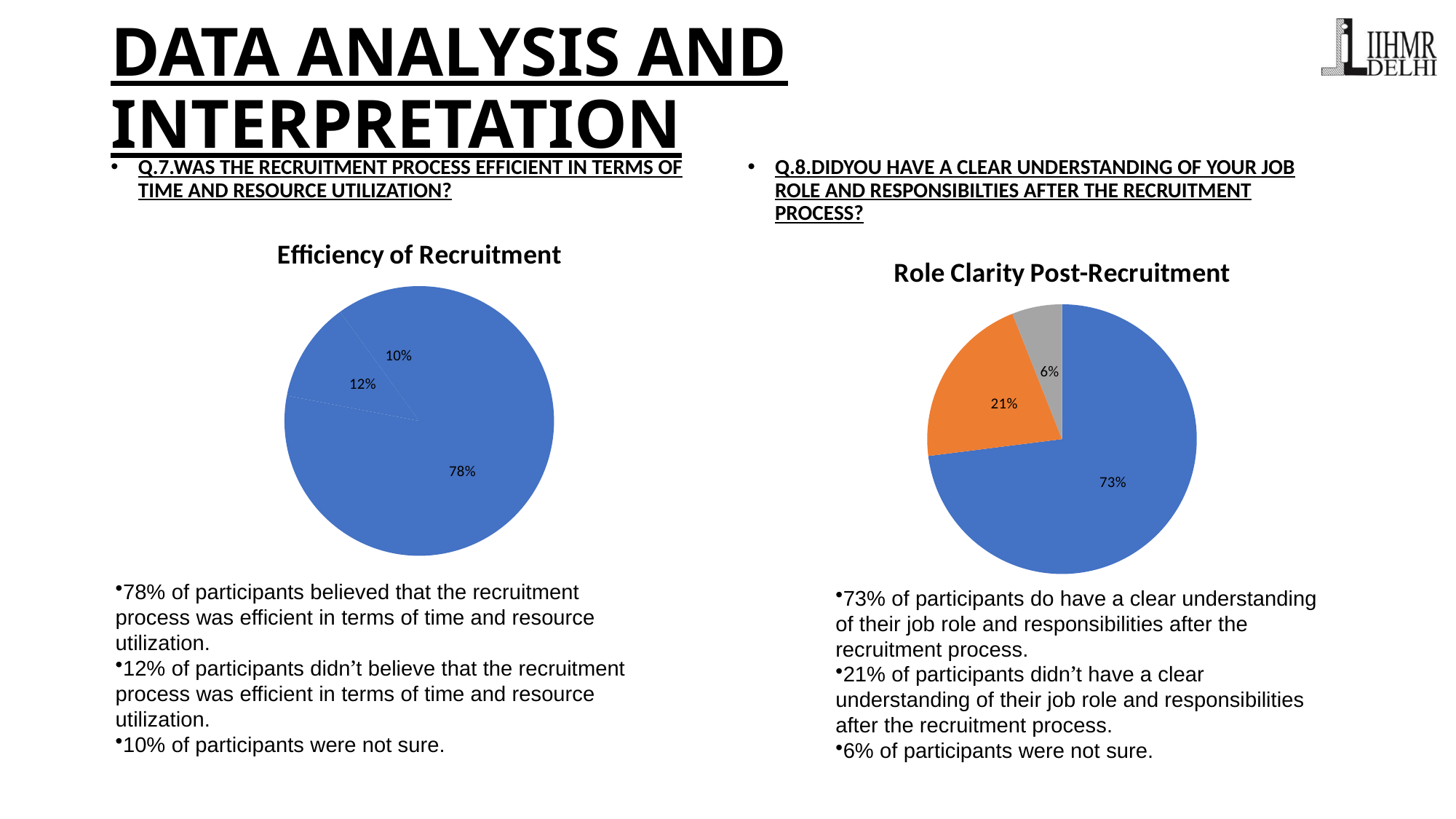
What kind of chart is the 'Efficiency of Recruitment' chart? pie chart In the 'Role Clarity Post-Recruitment' chart, what is the difference between the largest and smallest slices? 67% How many slices does the 'Efficiency of Recruitment' pie chart have? 3 Which chart has the larger largest slice, 'Efficiency of Recruitment' or 'Role Clarity Post-Recruitment'? Efficiency of Recruitment In the 'Efficiency of Recruitment' chart, what is the difference between the 12% slice and the 10% slice? 2% What kind of chart is the 'Role Clarity Post-Recruitment' chart? pie chart In the 'Role Clarity Post-Recruitment' chart, what share does the grey slice represent? 6% How many slices does the 'Role Clarity Post-Recruitment' pie chart have? 3 In the 'Role Clarity Post-Recruitment' chart, what share does the blue slice represent? 73% In the 'Role Clarity Post-Recruitment' chart, what share does the orange slice represent? 21%